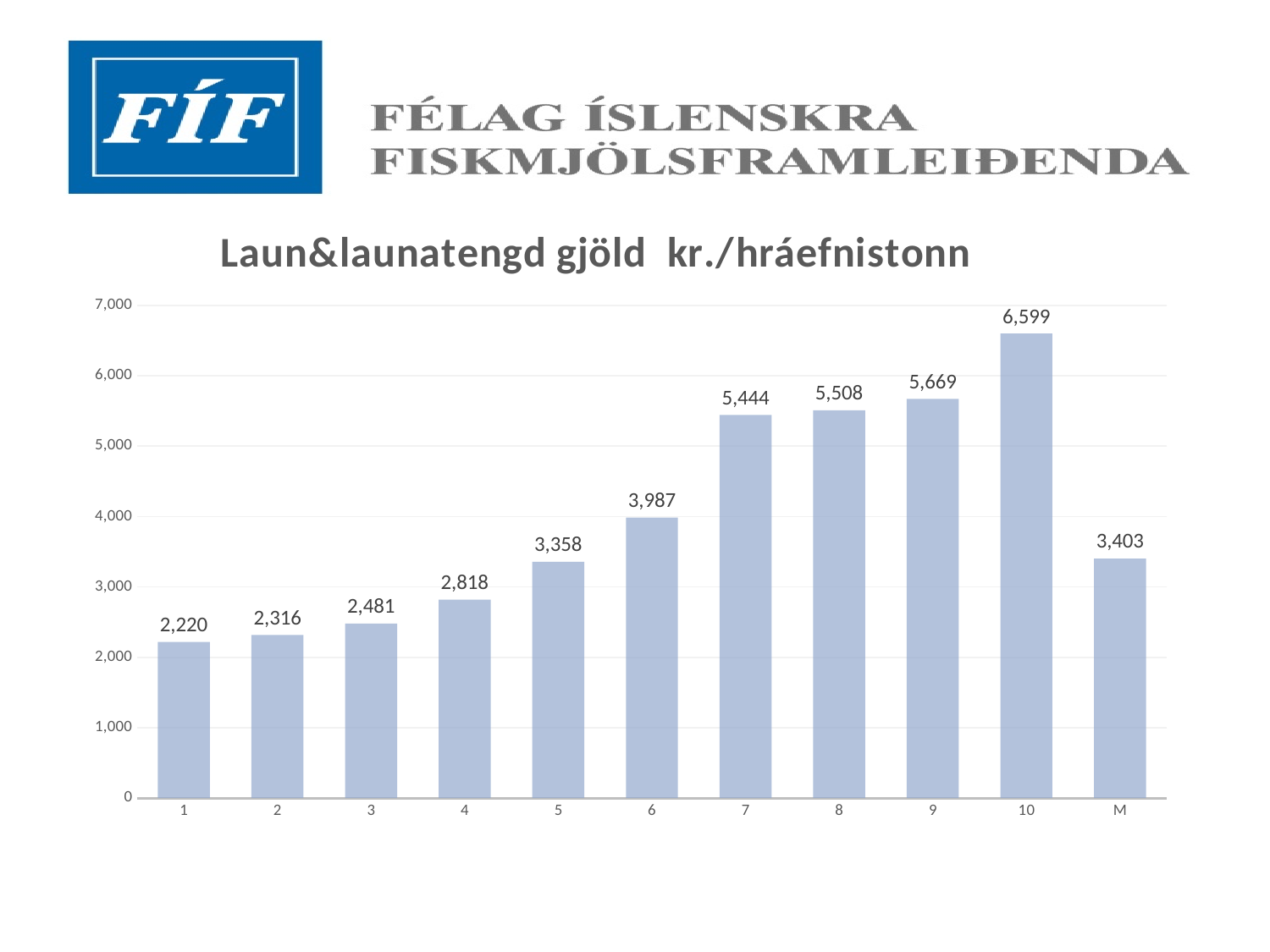
Which category has the highest value? 10 Which category has the lowest value? 1 What is the title of the chart? Laun&launatengd gjöld kr./hráefnistonn What is the value for category 7? 5,444 What is the difference between the values for category 10 and category 9? 930 Which is larger, the value for category 6 or the value for category M? 6 What is the value for category M? 3,403 Is the value for category 5 greater or less than 3,000? greater What is the value for category 1? 2,220 How many bars are shown in the chart? 11 Do the values rise or fall from category 1 to category 10? rise What kind of chart is shown on the slide? bar chart